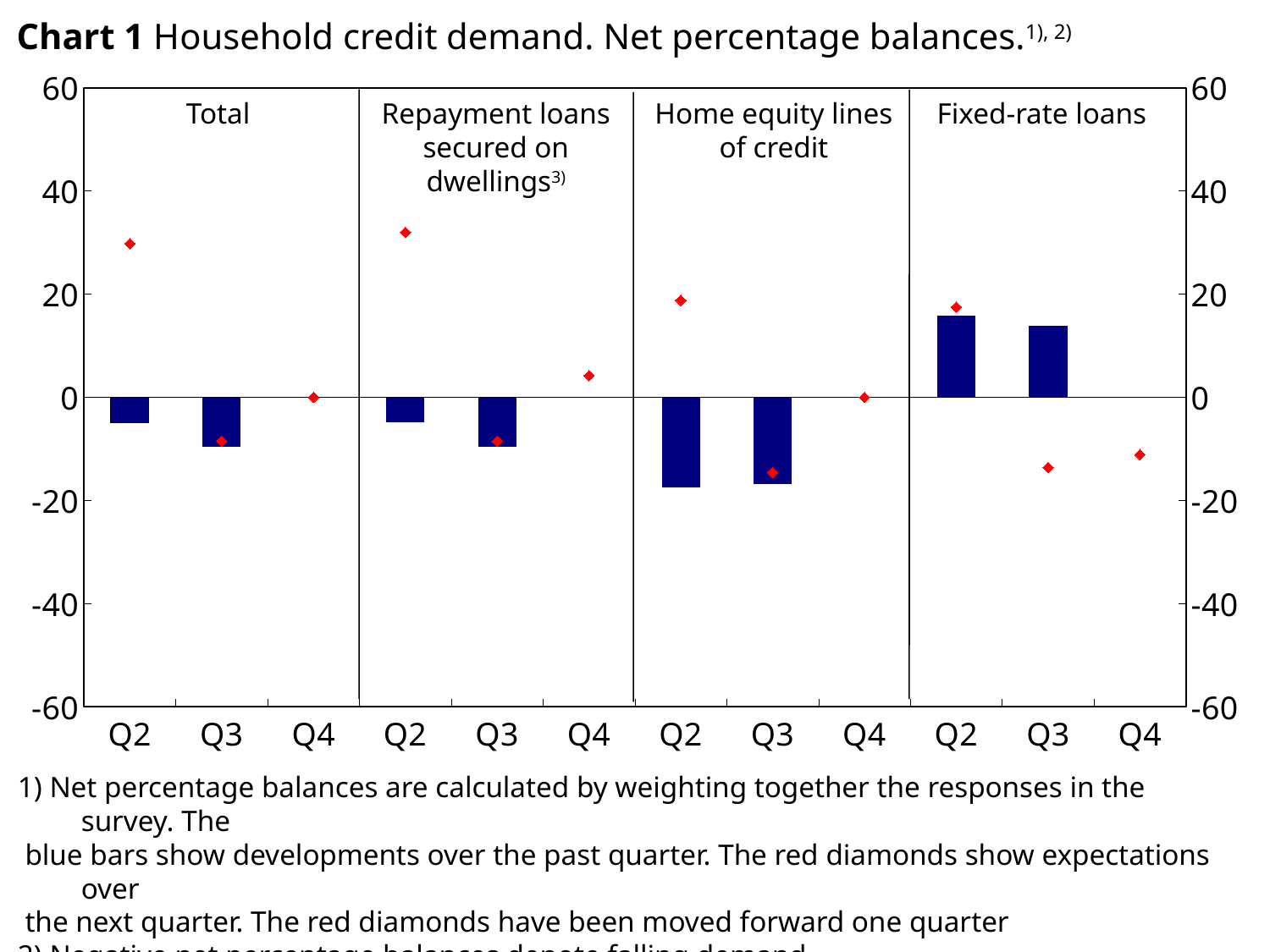
What kind of chart is Chart 1? combination bar and line chart (blue bars with red diamond markers) How many panels (loan categories) are shown in Chart 1? 4 Is the Q3 red diamond for Fixed-rate loans greater or less than 0? less Which panel of Chart 1 contains the lowest (most negative) blue bar? Home equity lines of credit Is the Q2 blue bar for Home equity lines of credit greater or less than -10? less Is the Q2 blue bar for Fixed-rate loans greater or less than 20? less According to the footnote, what do the red diamonds in Chart 1 show? Expectations over the next quarter In the Total panel, which quarter has the lower (more negative) blue bar, Q2 or Q3? Q3 In the Fixed-rate loans panel, do the red diamonds rise or fall from Q2 to Q3? fall Which panel of Chart 1 is the only one with positive (above zero) blue bars? Fixed-rate loans